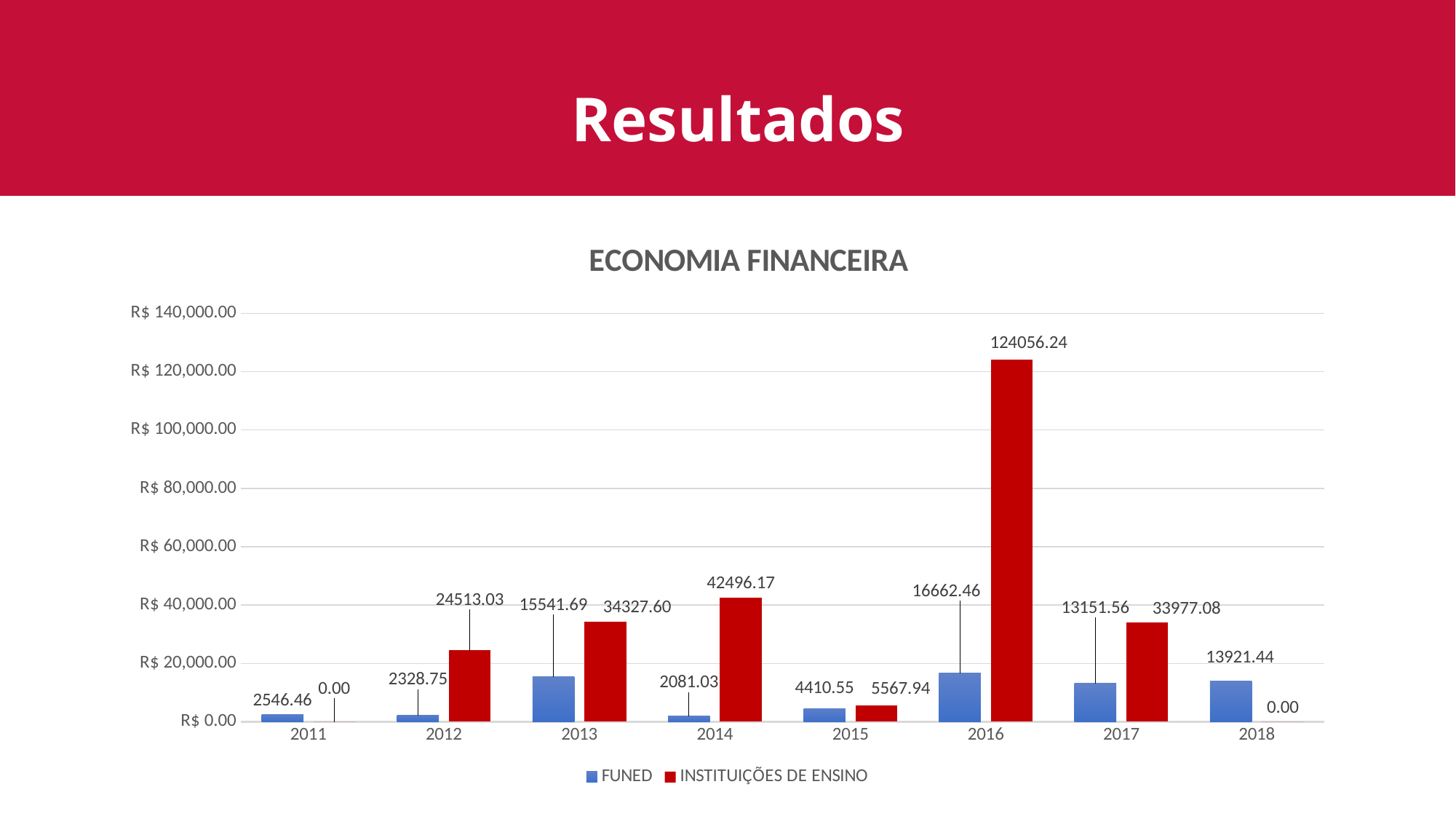
How many series does the legend list? 2 What is the value for INSTITUIÇÕES DE ENSINO in 2014? 42496.17 In which year is the FUNED value highest? 2016 What is the value for FUNED in 2013? 15541.69 What is the value for INSTITUIÇÕES DE ENSINO in 2016? 124056.24 What type of chart is shown? Bar chart What is the difference between INSTITUIÇÕES DE ENSINO and FUNED in 2016? 107393.78 How many years are shown on the x axis? 8 What is the value for FUNED in 2018? 13921.44 In which year is the INSTITUIÇÕES DE ENSINO value highest? 2016 Which series has the larger value in 2015, FUNED or INSTITUIÇÕES DE ENSINO? INSTITUIÇÕES DE ENSINO In which year is the FUNED value lowest? 2014